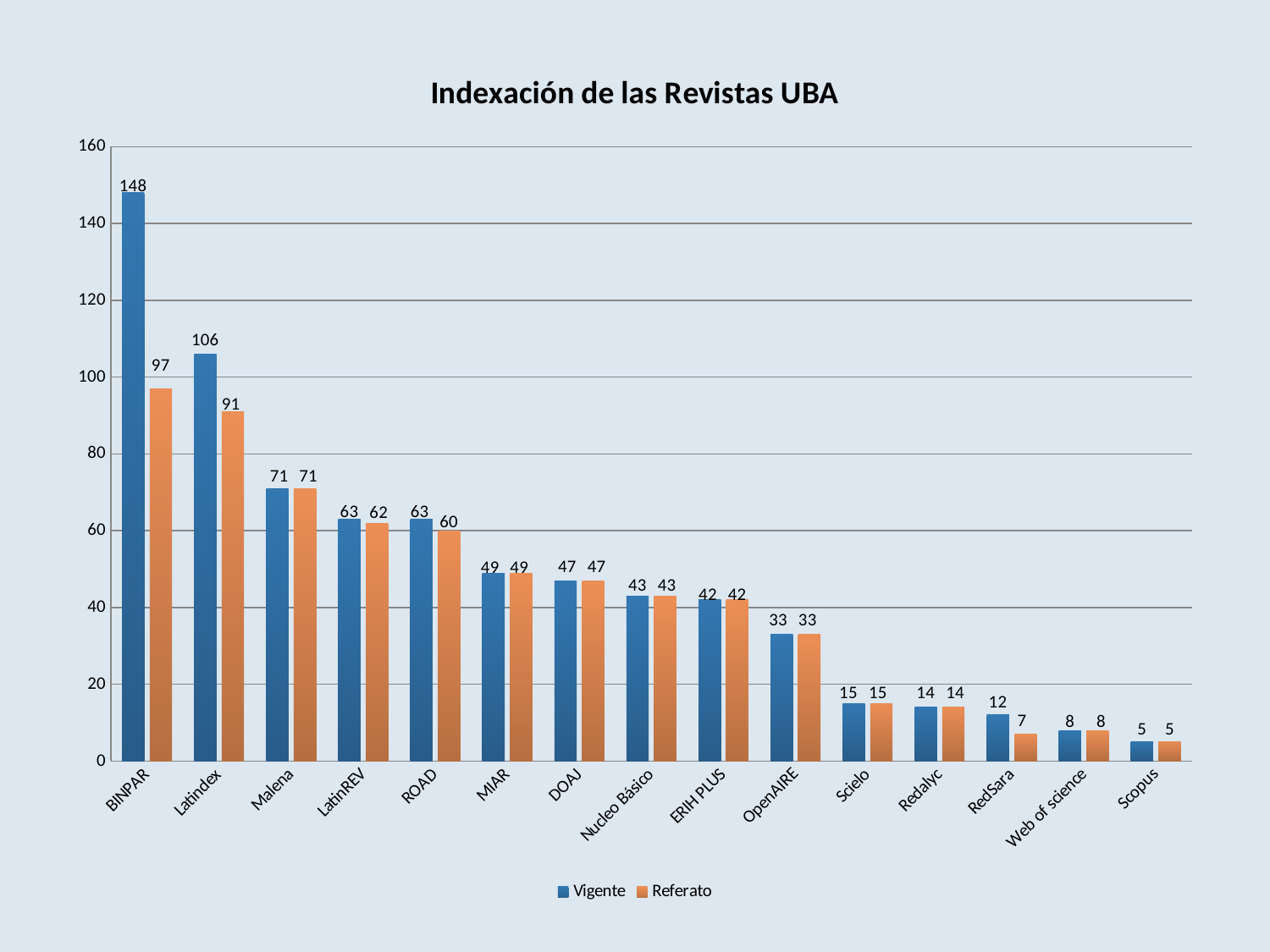
How many categories are shown on the x axis? 15 How many series does the legend list? 2 What is the Referato value for RedSara? 7 What is the difference between the Vigente values for Latindex and Malena? 35 What is the title of the chart? Indexación de las Revistas UBA What is the difference between the Vigente and Referato values for BINPAR? 51 Which is larger, the Vigente value for ROAD or the Referato value for ROAD? Vigente Which category has the lowest Referato value? Scopus What is the Vigente value for BINPAR? 148 What kind of chart is shown on the slide? Bar chart What is the Referato value for Latindex? 91 Which category has the highest Vigente value? BINPAR